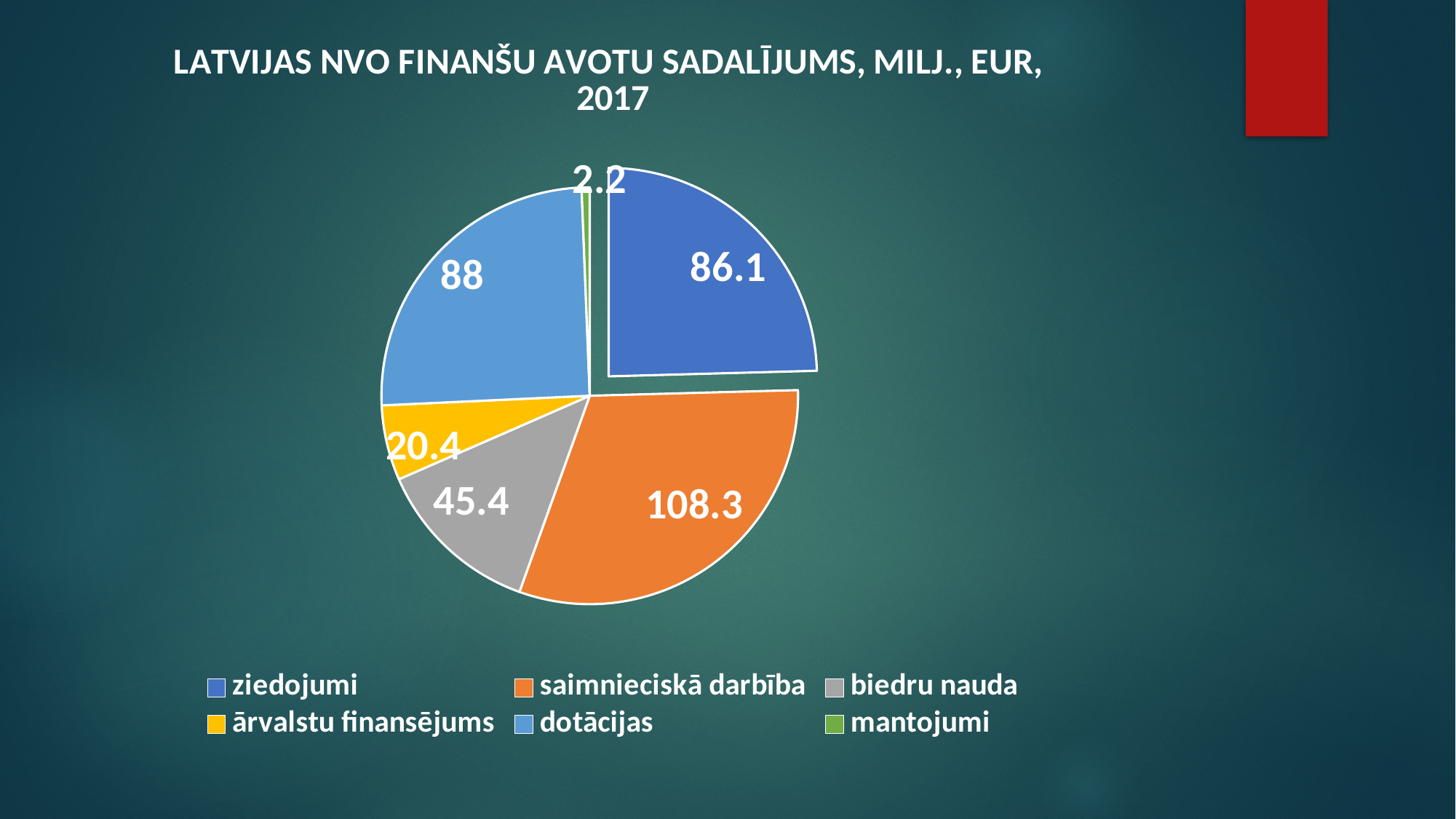
What is the difference between saimnieciskā darbība and ziedojumi? 22.2 What is the title of the chart? LATVIJAS NVO FINANŠU AVOTU SADALĪJUMS, MILJ., EUR, 2017 What is the value for ārvalstu finansējums? 20.4 What is the value for dotācijas? 88 What type of chart is shown on the slide? pie chart How many categories does the pie chart have? 6 What is the value for saimnieciskā darbība? 108.3 Which category has the largest slice? saimnieciskā darbība Which is larger, biedru nauda or ārvalstu finansējums? biedru nauda Which category has the smallest slice? mantojumi What is the difference between dotācijas and biedru nauda? 42.6 What is the value for mantojumi? 2.2